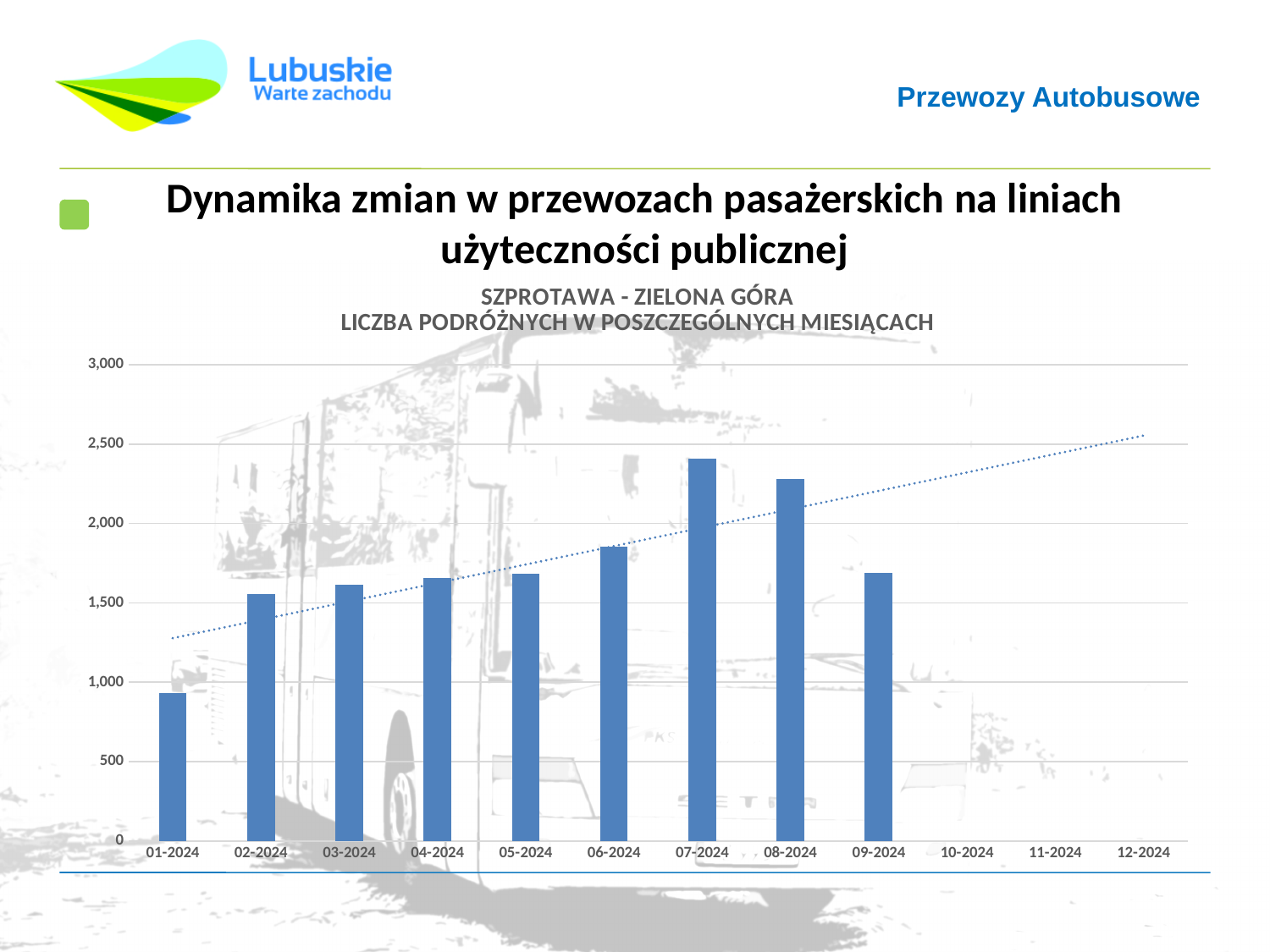
What kind of chart is shown on the slide? bar chart Which month has the highest number of passengers? 07-2024 Is the value for 08-2024 greater or less than 2,500? less How many months have a bar plotted on the chart? 9 Is the value for 01-2024 greater or less than 1,000? less Which month has the lowest number of passengers? 01-2024 Which is larger, the value for 02-2024 or the value for 06-2024? 06-2024 Which is larger, the value for 07-2024 or the value for 08-2024? 07-2024 Does the dotted trend line rise or fall from left to right? rise Is the value for 07-2024 greater or less than 2,000? greater